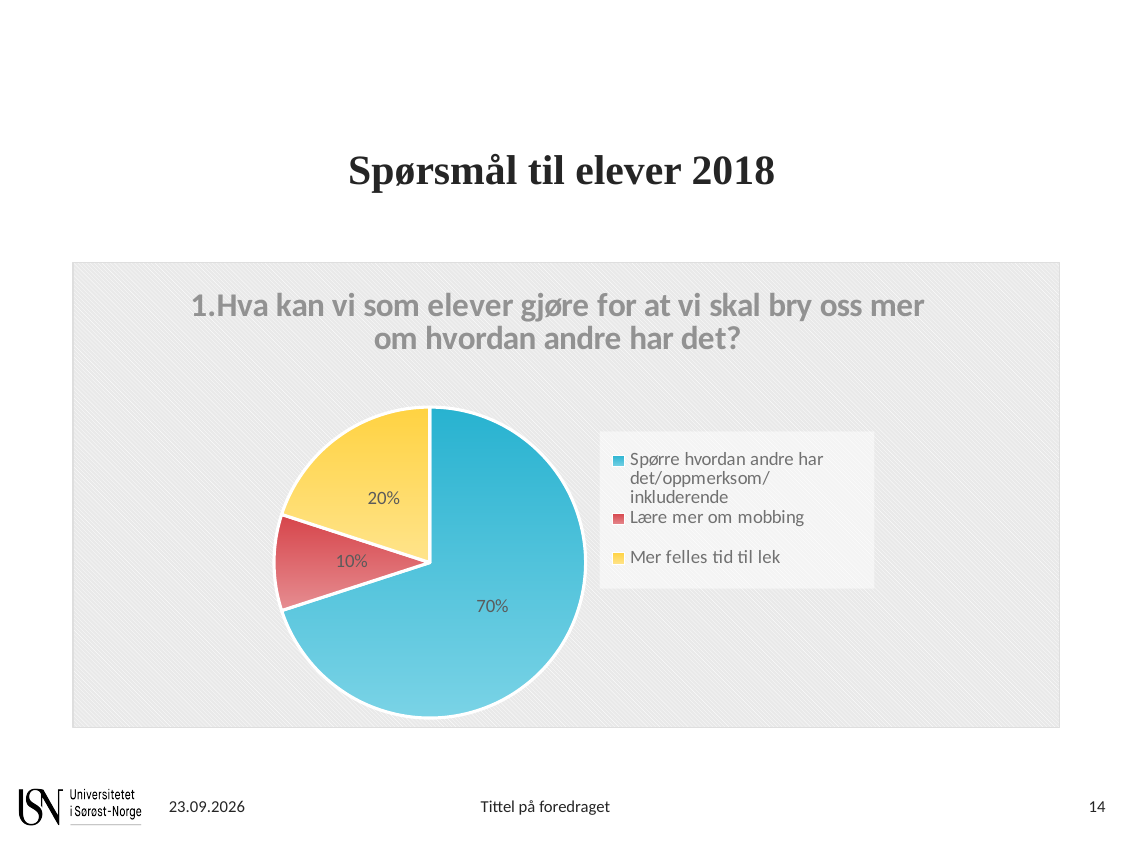
What share of the pie does "Mer felles tid til lek" have? 20% What is the title of the chart? 1.Hva kan vi som elever gjøre for at vi skal bry oss mer om hvordan andre har det? Which category has the largest slice of the pie? Spørre hvordan andre har det/oppmerksom/inkluderende How many entries does the legend list? 3 What share of the pie does "Lære mer om mobbing" have? 10% Which slice is larger: "Mer felles tid til lek" or "Lære mer om mobbing"? Mer felles tid til lek What share of the pie does "Spørre hvordan andre har det/oppmerksom/inkluderende" have? 70% What kind of chart is shown on the slide? pie chart What is the difference in percentage points between the "Spørre hvordan andre har det/oppmerksom/inkluderende" slice and the "Mer felles tid til lek" slice? 50 percentage points Which category has the smallest slice of the pie? Lære mer om mobbing How many slices does the pie chart have? 3 What colour is the slice for "Lære mer om mobbing"? red